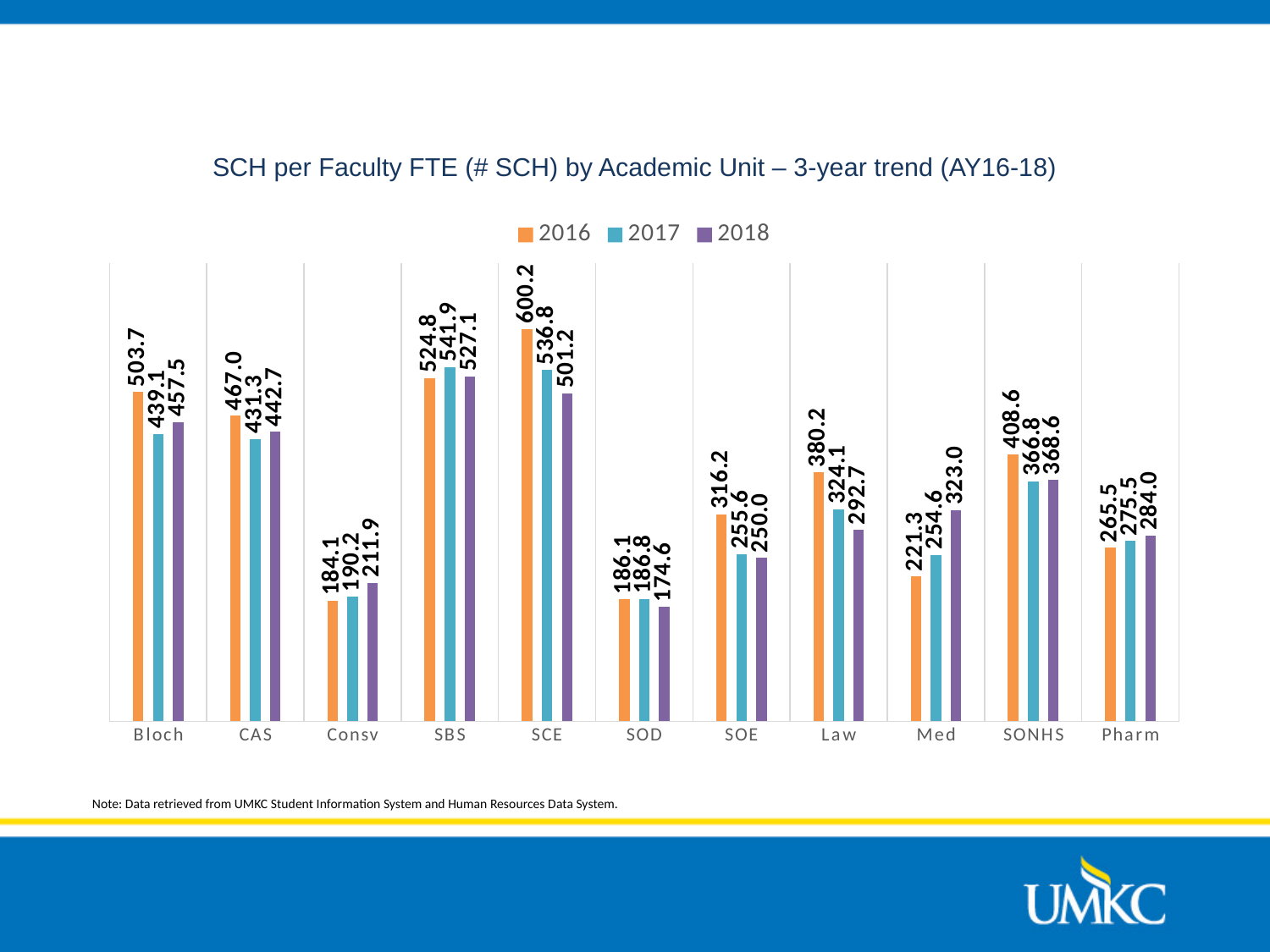
What is the 2018 value for Med? 323.0 How many series does the legend list? 3 What is the 2016 value for SCE? 600.2 Which academic unit has the highest 2016 value? SCE What is the title of the chart? SCH per Faculty FTE (# SCH) by Academic Unit – 3-year trend (AY16-18) Do the values for Med rise or fall from 2016 to 2018? Rise What is the 2017 value for Pharm? 275.5 What kind of chart is shown on the slide? Bar chart Which is larger, the 2017 value for SBS or the 2017 value for SCE? SBS Which academic unit has the lowest 2018 value? SOD What is the difference between the 2016 and 2018 values for SCE? 99.0 How many academic units are shown on the x axis? 11